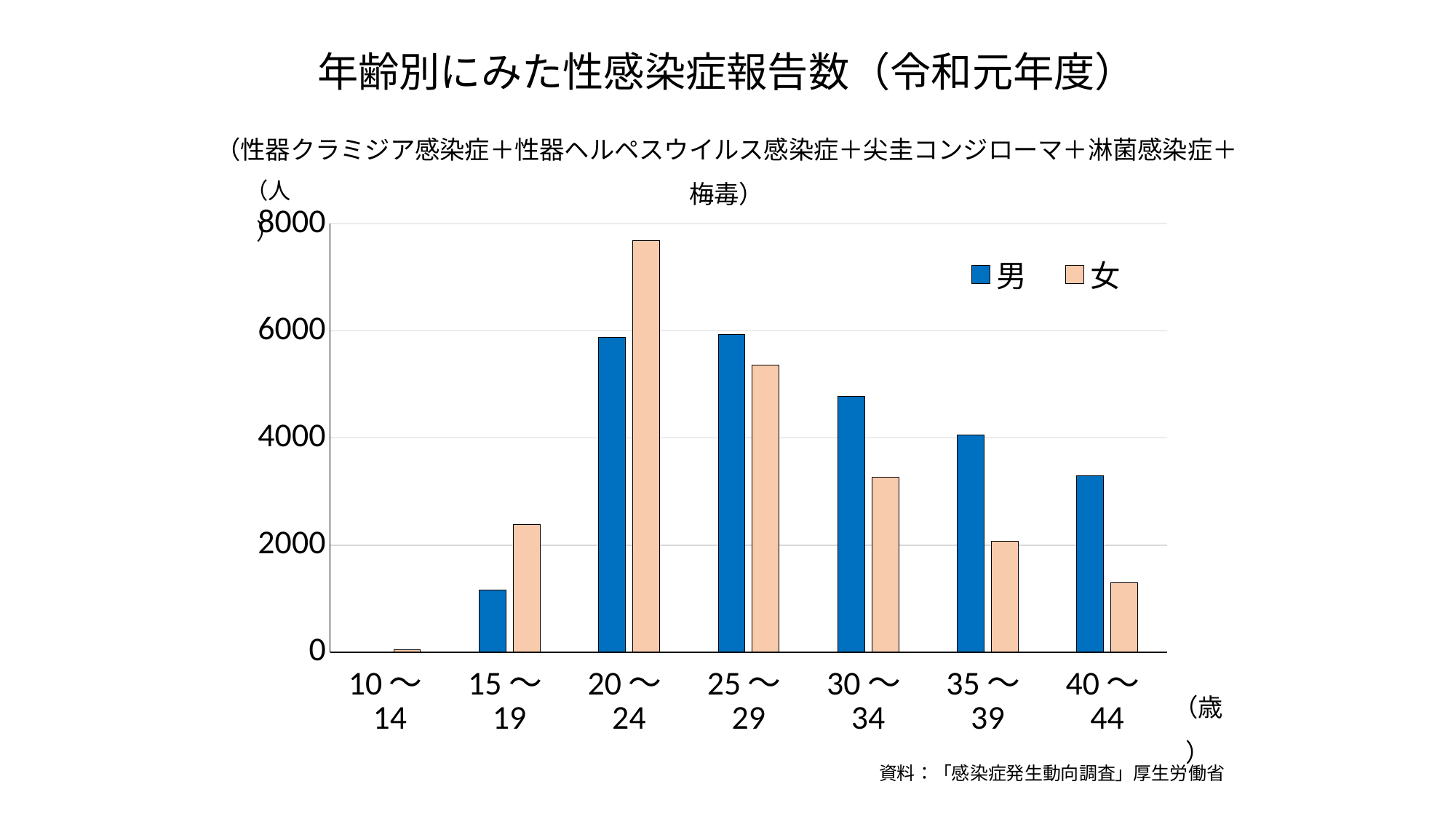
How many series does the legend list? 2 What kind of chart is shown on the slide? bar chart Is the value for 男 in the 30〜34 age group greater or less than 4000? greater In the 15〜19 age group, which is larger, 男 or 女? 女 Do the values for 女 rise or fall from the 20〜24 age group to the 40〜44 age group? fall In the 30〜34 age group, which is larger, 男 or 女? 男 How many age groups are shown on the x axis? 7 Which age group has the highest value for 女? 20〜24 Which colour represents 男 in the legend? blue Is the value for 女 in the 20〜24 age group greater or less than 6000? greater Which age group has the lowest value for 女? 10〜14 Is the value for 女 in the 40〜44 age group greater or less than 2000? less